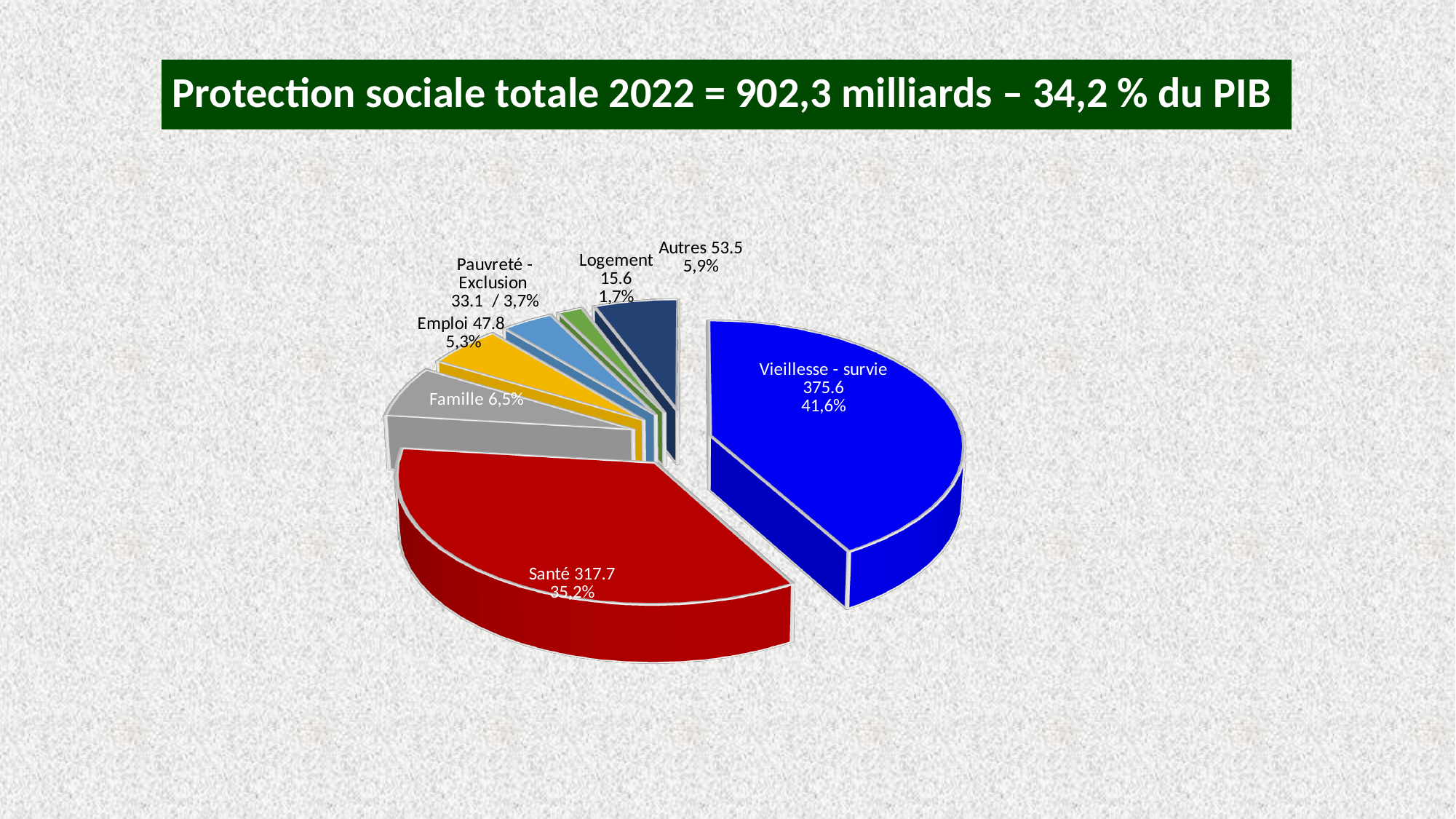
How many slices does the pie chart have? 7 What is the value shown for Emploi? 47.8 What is the value shown for Autres? 53.5 What percentage share is shown for Santé? 35,2% Which is larger, the value for Emploi or the value for Pauvreté - Exclusion? Emploi What is the difference between the values for Vieillesse - survie and Santé? 57.9 What kind of chart is shown on the slide? Pie chart What is the value shown for Vieillesse - survie? 375.6 Which category has the largest slice of the pie? Vieillesse - survie What percentage share is shown for Logement? 1,7% What percentage share is shown for Famille? 6,5% Which category has the smallest slice of the pie? Logement